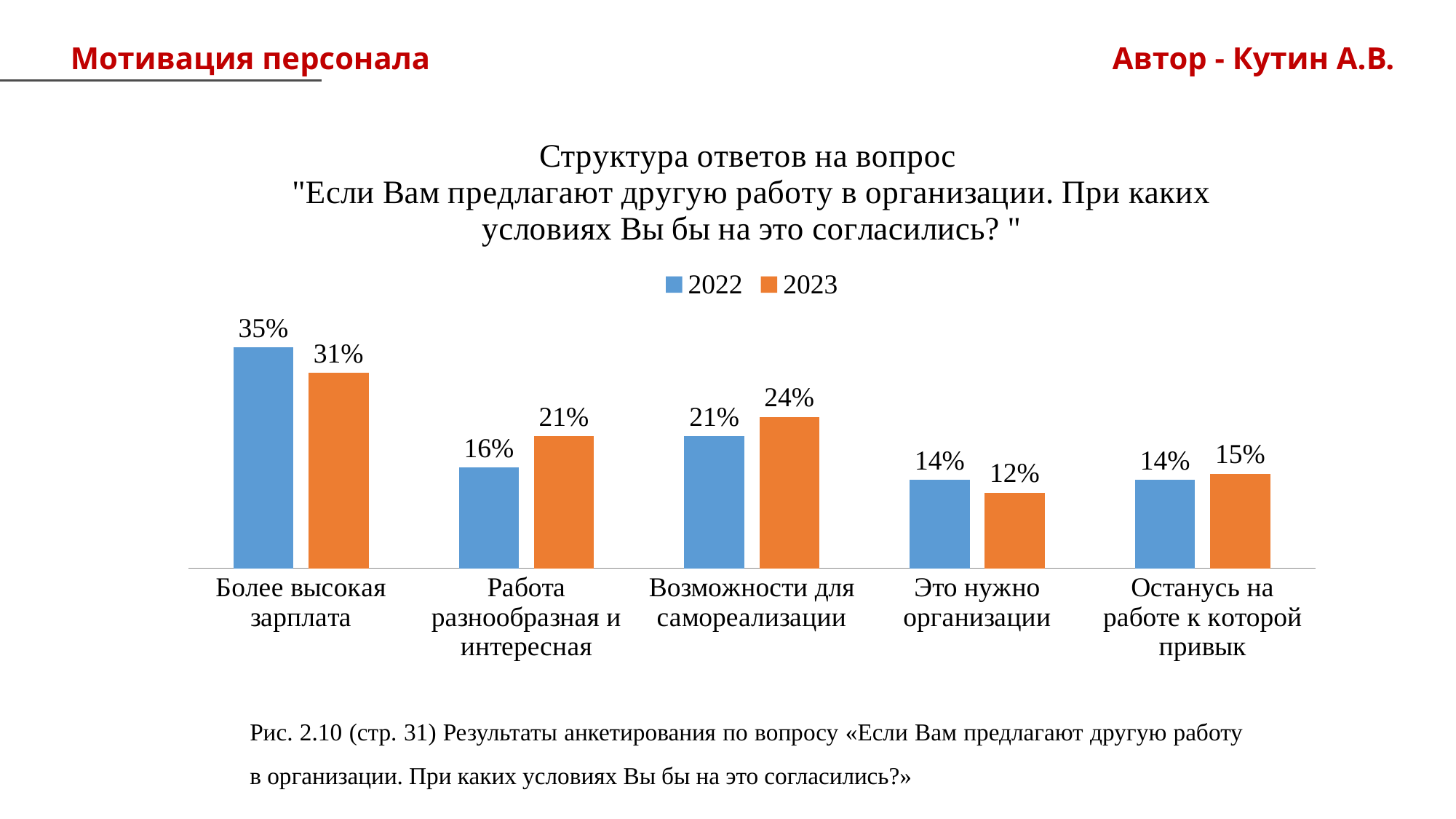
What is the 2023 value for "Это нужно организации"? 12% What is the 2023 value for "Возможности для самореализации"? 24% What is the difference between the 2022 and 2023 values for "Более высокая зарплата"? 4% What is the 2022 value for "Более высокая зарплата"? 35% Which category has the highest 2022 value? Более высокая зарплата What is the difference between the 2022 and 2023 values for "Работа разнообразная и интересная"? 5% Which category has the lowest 2023 value? Это нужно организации Which is larger for "Это нужно организации": the 2022 value or the 2023 value? 2022 How many series does the legend list? 2 How many categories are shown on the x axis? 5 Which colour represents the 2023 series? Orange What kind of chart is shown on the slide? Bar chart